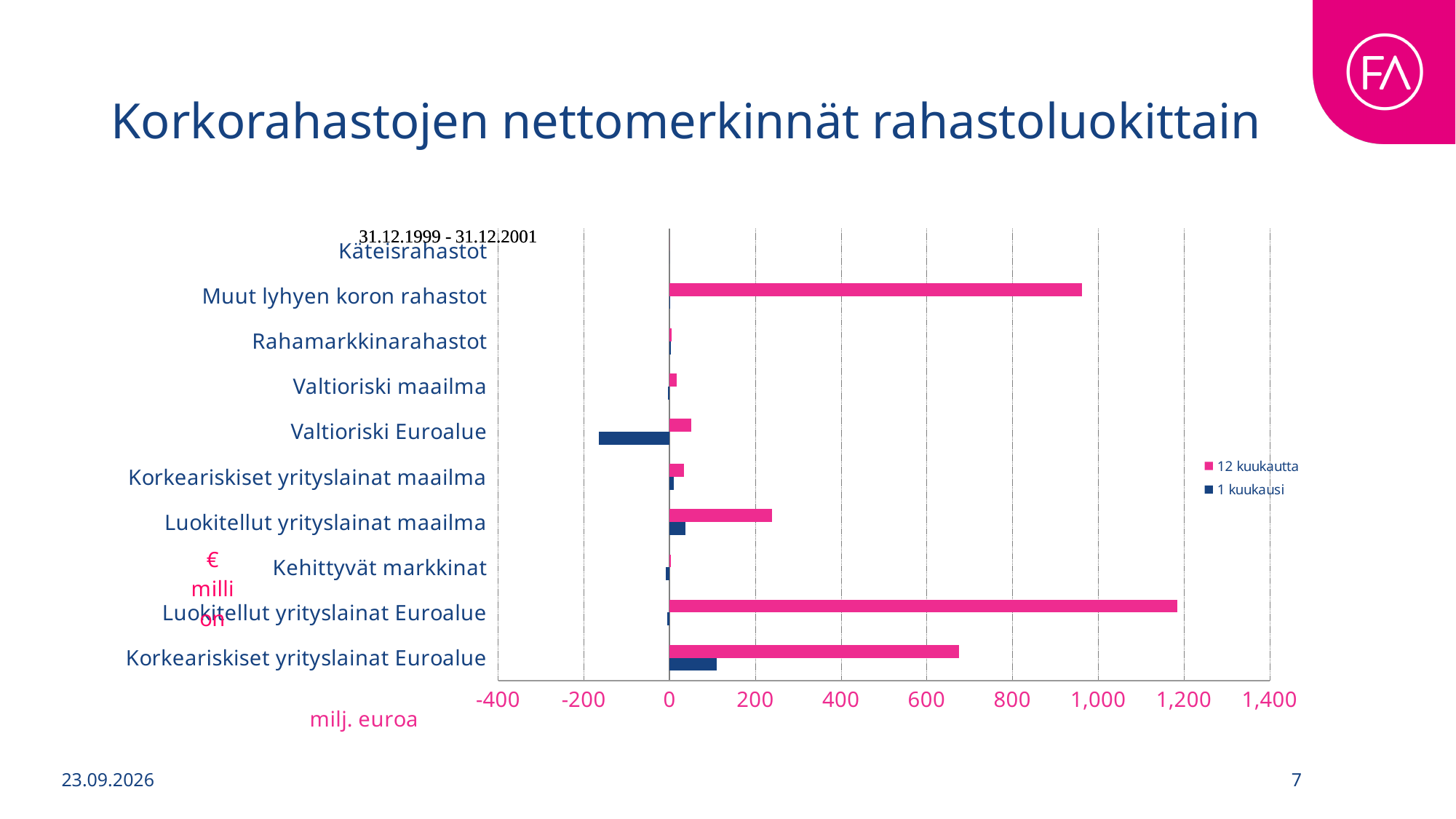
Which category has the lowest value for the 1 kuukausi series? Valtioriski Euroalue How many fund categories are listed on the vertical axis of the chart? 10 What unit is shown below the horizontal axis of the chart? milj. euroa What kind of chart is shown on the slide? bar chart Is the 12 kuukautta value for Muut lyhyen koron rahastot greater or less than 800? greater For the 12 kuukautta series, which is larger: Muut lyhyen koron rahastot or Korkeariskiset yrityslainat Euroalue? Muut lyhyen koron rahastot Is the 12 kuukautta value for Luokitellut yrityslainat Euroalue greater or less than 1,000? greater Is the 12 kuukautta value for Korkeariskiset yrityslainat Euroalue greater or less than 600? greater Which category has the highest value for the 1 kuukausi series? Korkeariskiset yrityslainat Euroalue Which category has the highest value for the 12 kuukautta series? Luokitellut yrityslainat Euroalue How many series does the chart legend list? 2